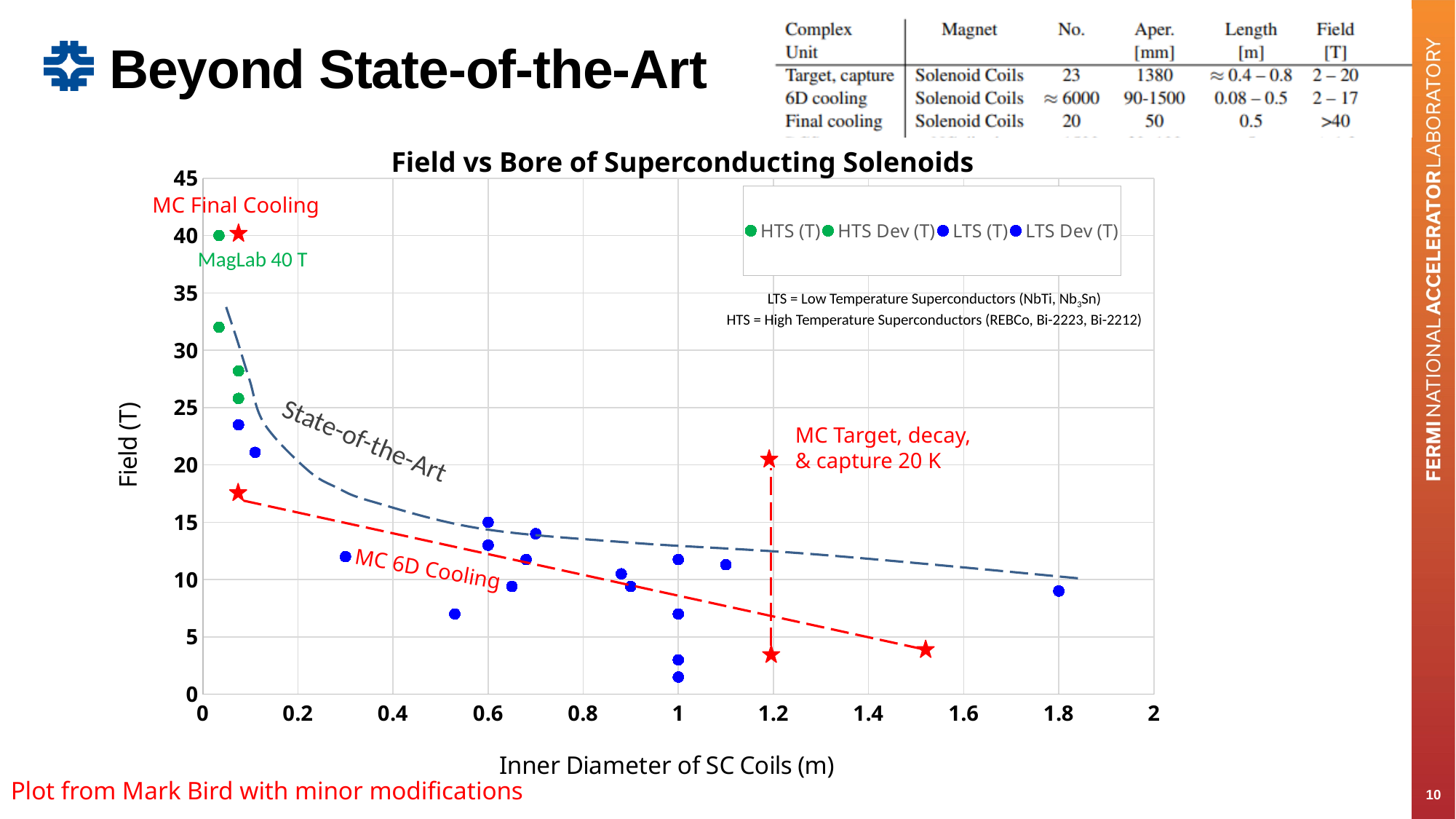
What is the label of the vertical axis of the chart? Field (T) What kind of chart is shown on the slide? Scatter chart What is the title of the chart? Field vs Bore of Superconducting Solenoids Which has the larger field: the MC Final Cooling star or the MC Target, decay & capture star? MC Final Cooling Is the field value of the highest green HTS point below 40 T greater or less than 30 T? greater What is the largest inner diameter value shown on the x axis of the chart? 2 How many series does the chart legend list? 4 Is the field value of the lowest blue point at an inner diameter of 1 m greater or less than 5 T? less Is the field value of the blue point at an inner diameter of 0.3 m greater or less than 10 T? greater What field value is labelled for the MagLab point on the chart? 40 T Does the field of the State-of-the-Art dashed line rise or fall as the inner diameter increases? Fall